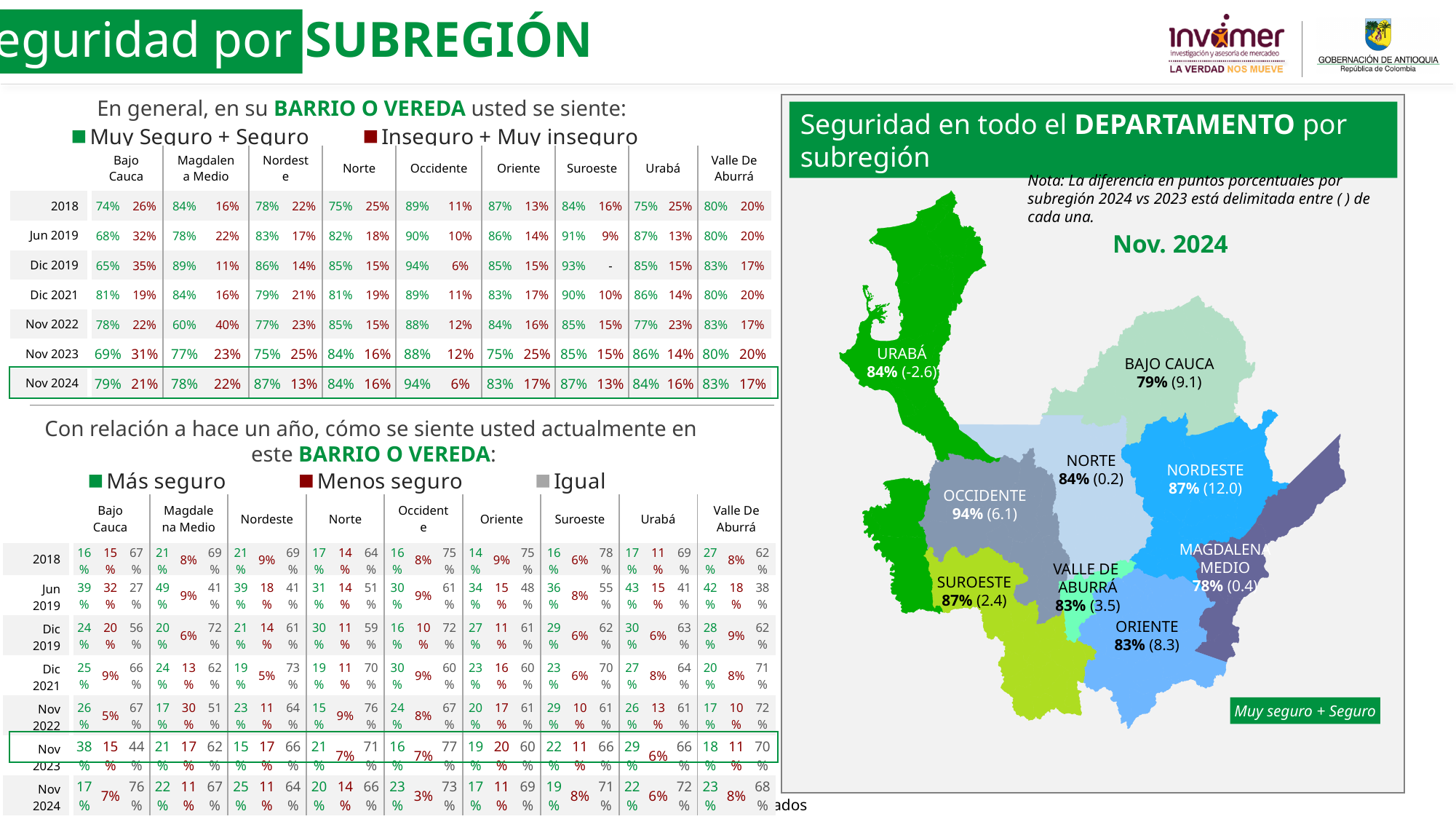
On the map chart, which month and year do the values refer to? Nov. 2024 On the map chart 'Seguridad en todo el DEPARTAMENTO por subregión', what is the value shown for Occidente? 94% On the map chart, which subregion is the only one with a negative change in parentheses? Urabá On the map chart, which subregion has the highest 'Muy seguro + Seguro' value? Occidente On the map chart, what is the change in percentage points shown in parentheses for Nordeste? 12.0 On the map chart, what is the difference in percentage points between Occidente and Magdalena Medio? 16 On the map chart, which has a higher value, Nordeste or Bajo Cauca? Nordeste On the map chart, what is the value shown for Bajo Cauca? 79% On the map chart, how many subregions are labelled with values? 9 On the map chart, which subregion has the lowest 'Muy seguro + Seguro' value? Magdalena Medio On the map chart, what is the value shown for Magdalena Medio? 78% On the map chart, what is the value shown for Suroeste? 87%